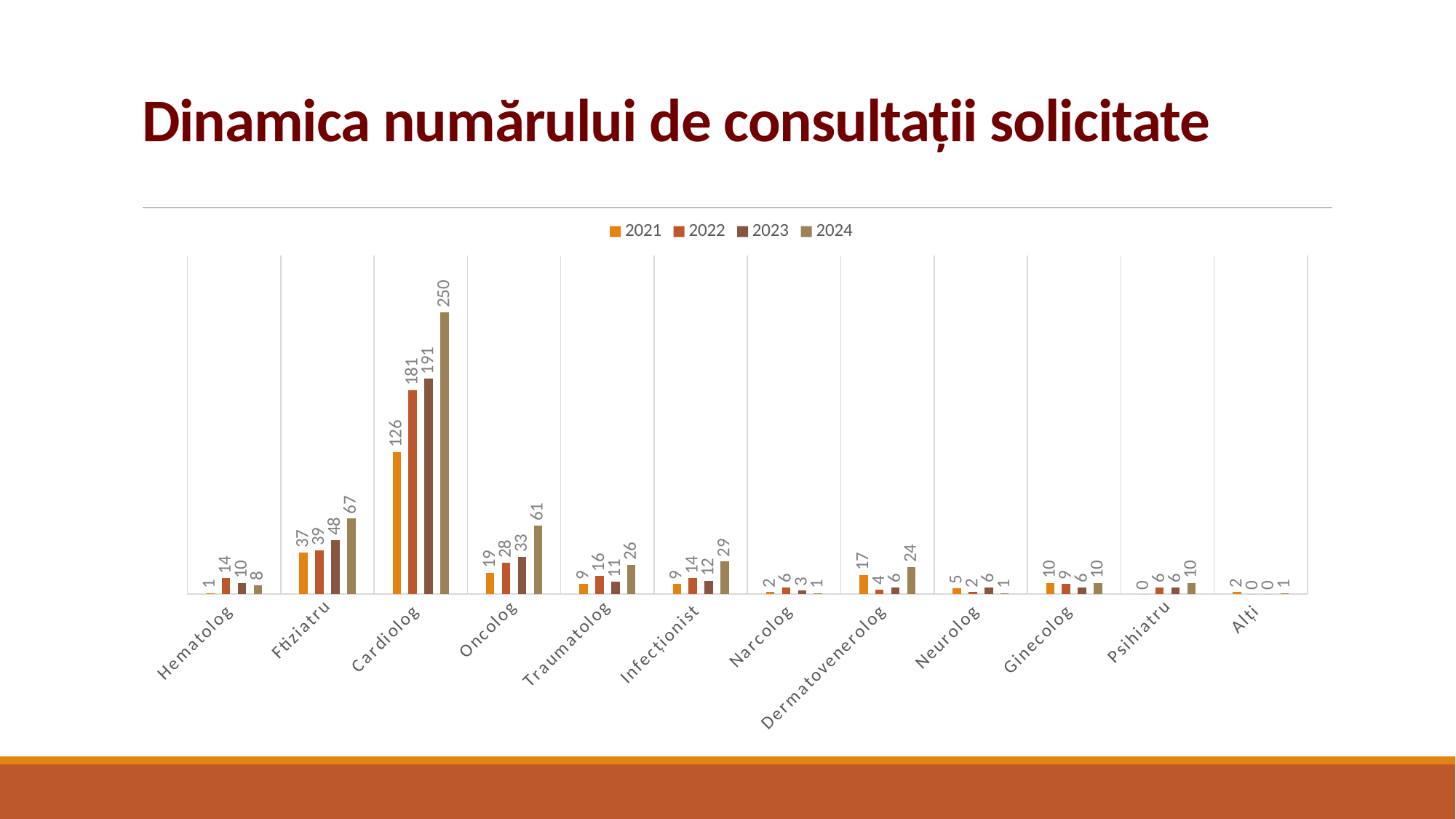
Which category has the lowest value in 2022? Alți What is the value for Dermatovenerolog in 2021? 17 Which category has the highest value in 2024? Cardiolog What is the value for Ftiziatru in 2023? 48 Do the values for Cardiolog rise or fall from 2021 to 2024? Rise What is the difference between the 2024 and 2021 values for Cardiolog? 124 What is the value for Cardiolog in 2024? 250 How many categories are shown on the x axis? 12 What kind of chart is shown on the slide? Bar chart How many series does the legend list? 4 Which is larger for Oncolog: the 2023 value or the 2024 value? 2024 What is the title of the chart? Dinamica numărului de consultații solicitate